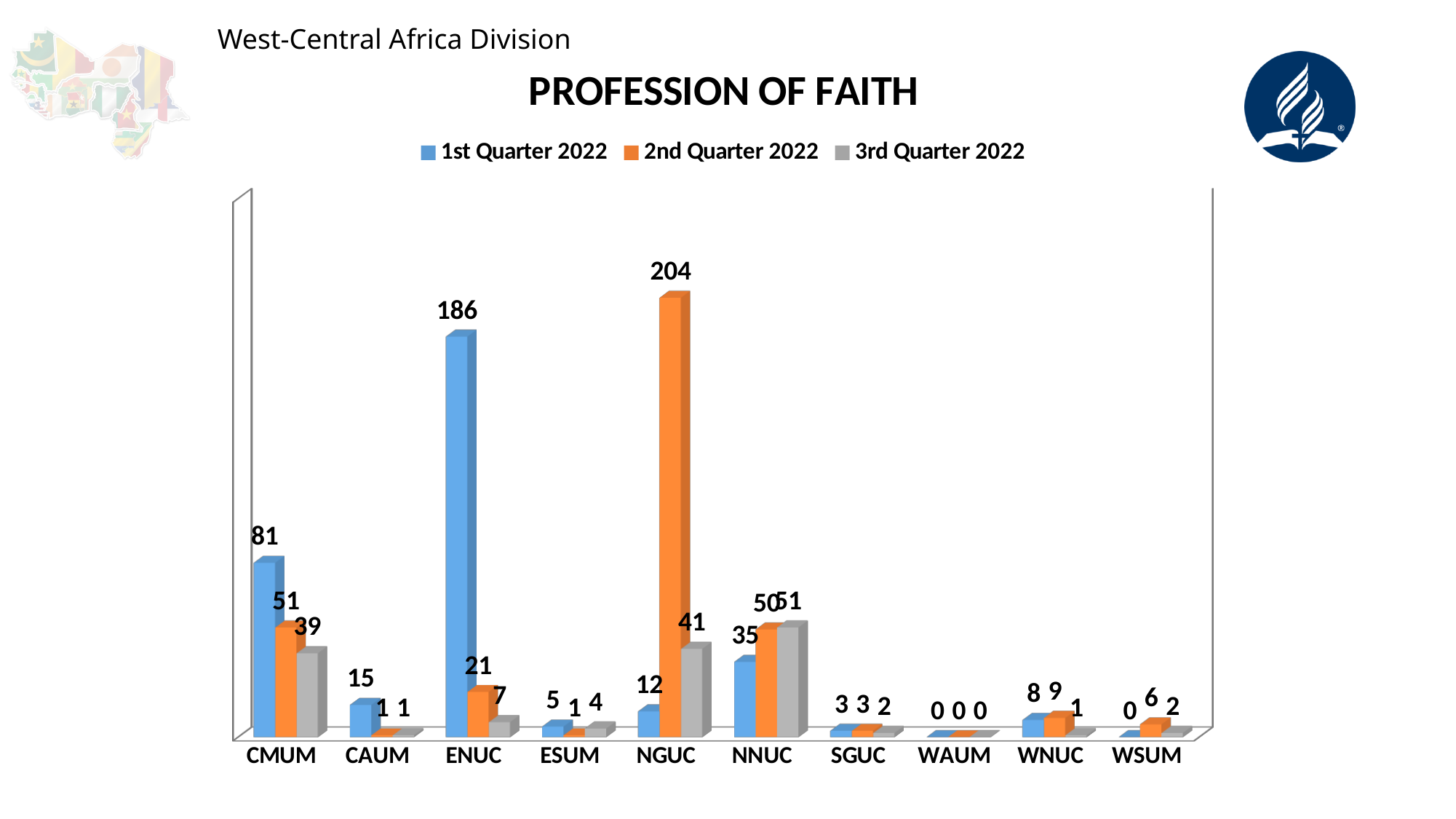
What is the value for WSUM in 2nd Quarter 2022? 6 How many series does the legend list? 3 Which category has the highest value in 1st Quarter 2022? ENUC What is the value for NGUC in 2nd Quarter 2022? 204 Which category has the lowest value in 3rd Quarter 2022? WAUM Which is larger in 1st Quarter 2022: CMUM or ENUC? ENUC What is the difference between the 2nd Quarter 2022 and 3rd Quarter 2022 values for NGUC? 163 Which category has the highest value in 2nd Quarter 2022? NGUC What kind of chart is shown on the slide? Bar chart How many categories are shown on the x axis? 10 What is the value for ENUC in 1st Quarter 2022? 186 What is the difference between the 1st Quarter 2022 and 2nd Quarter 2022 values for CMUM? 30